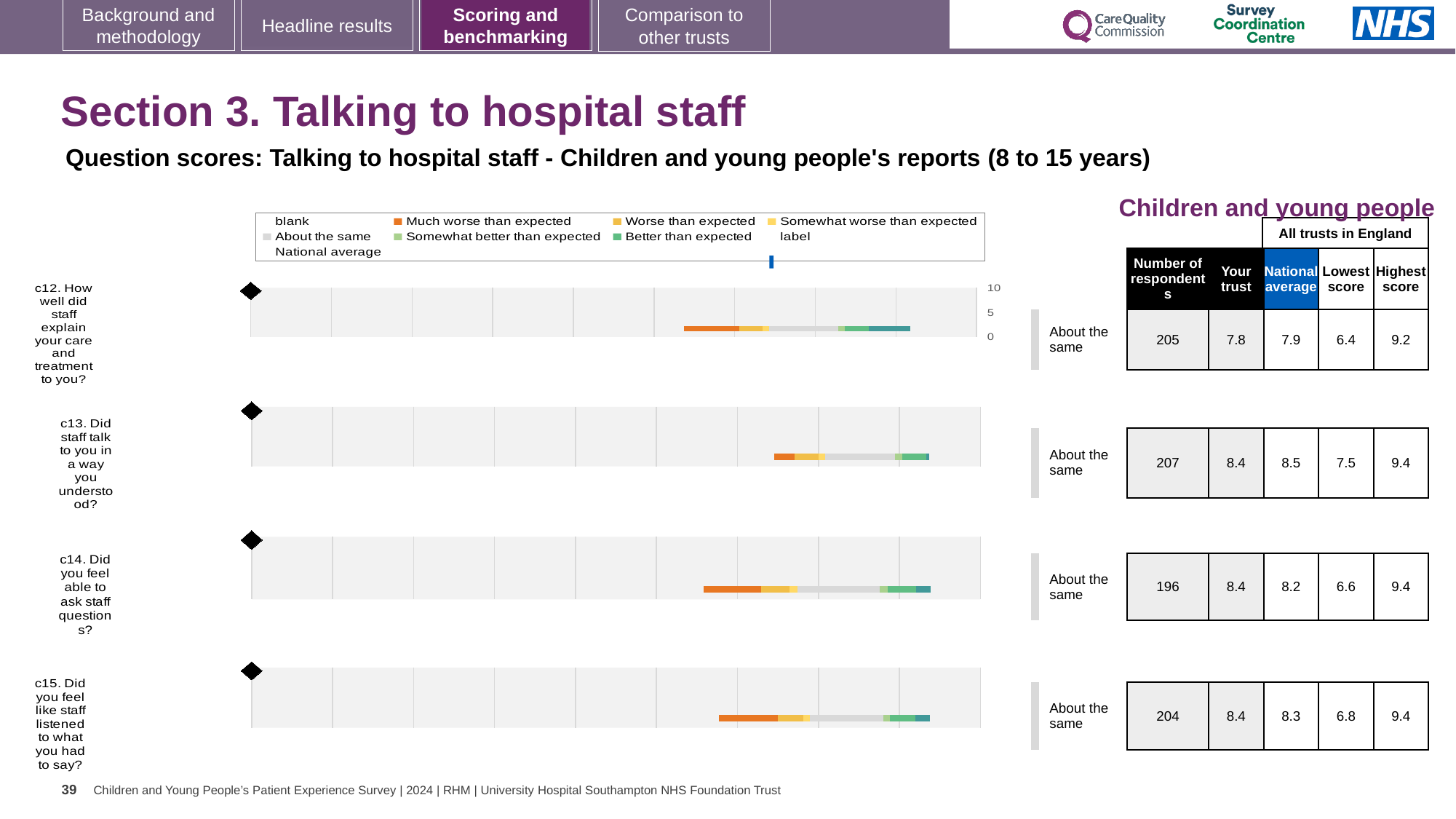
What is the lowest score among all trusts in England for question c15 (Did you feel like staff listened to what you had to say)? 6.8 Which has the larger 'Your trust' score, question c12 or question c13? c13 What is the national average score for question c14 (Did you feel able to ask staff questions)? 8.2 Which question has the lowest number of respondents? c14 In the table next to the charts, how many respondents answered question c12 (How well did staff explain your care and treatment to you)? 205 How many survey questions are charted on this slide? 4 What is the 'Your trust' score for question c13 (Did staff talk to you in a way you understood)? 8.4 What is the highest score among all trusts in England for question c12? 9.2 What benchmark label is shown for question c14 (Did you feel able to ask staff questions)? About the same What kind of chart is used to show the benchmarking bands for each question? Bar chart For question c12, what is the difference between the national average and the 'Your trust' score? 0.1 Which question has the highest number of respondents? c13